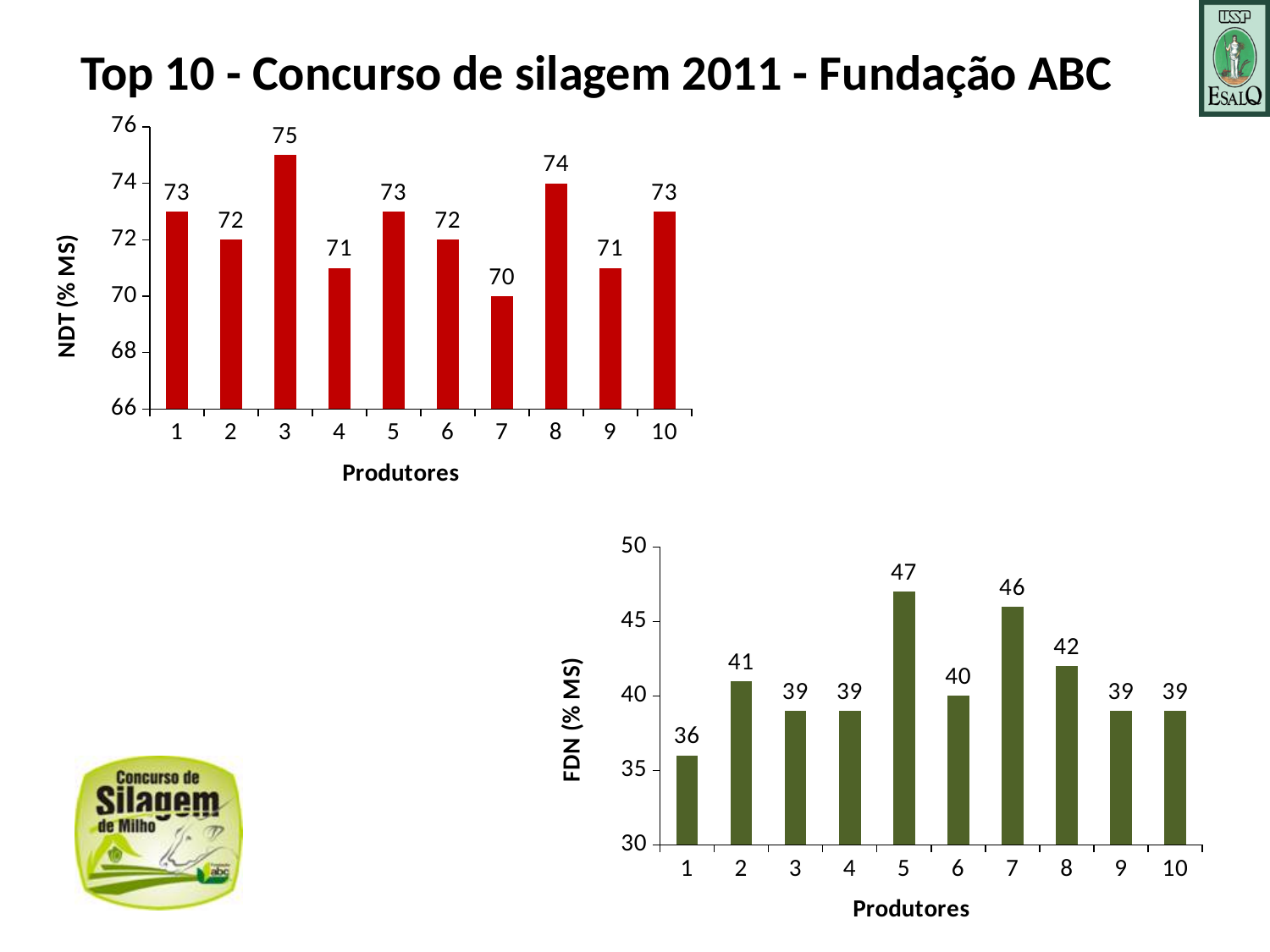
In the FDN (% MS) chart at the bottom right, what is the value for producer 7? 46 In the FDN (% MS) chart at the bottom right, what is the difference between producer 5 and producer 1? 11 In the FDN (% MS) chart at the bottom right, which producer has the highest value? 5 In the NDT (% MS) chart at the top left, what is the value for producer 8? 74 In the NDT (% MS) chart at the top left, which producer has the lowest value? 7 What is the title of the slide containing the two charts? Top 10 - Concurso de silagem 2011 - Fundação ABC In the NDT (% MS) chart at the top left, what is the value for producer 3? 75 In the FDN (% MS) chart at the bottom right, which producer has the lowest value? 1 In the NDT (% MS) chart at the top left, how many producers are shown on the x axis? 10 What kind of chart is the FDN (% MS) chart at the bottom right? Bar chart In the NDT (% MS) chart at the top left, what is the difference between producer 3 and producer 7? 5 In the FDN (% MS) chart at the bottom right, which is larger, the value for producer 2 or producer 6? Producer 2